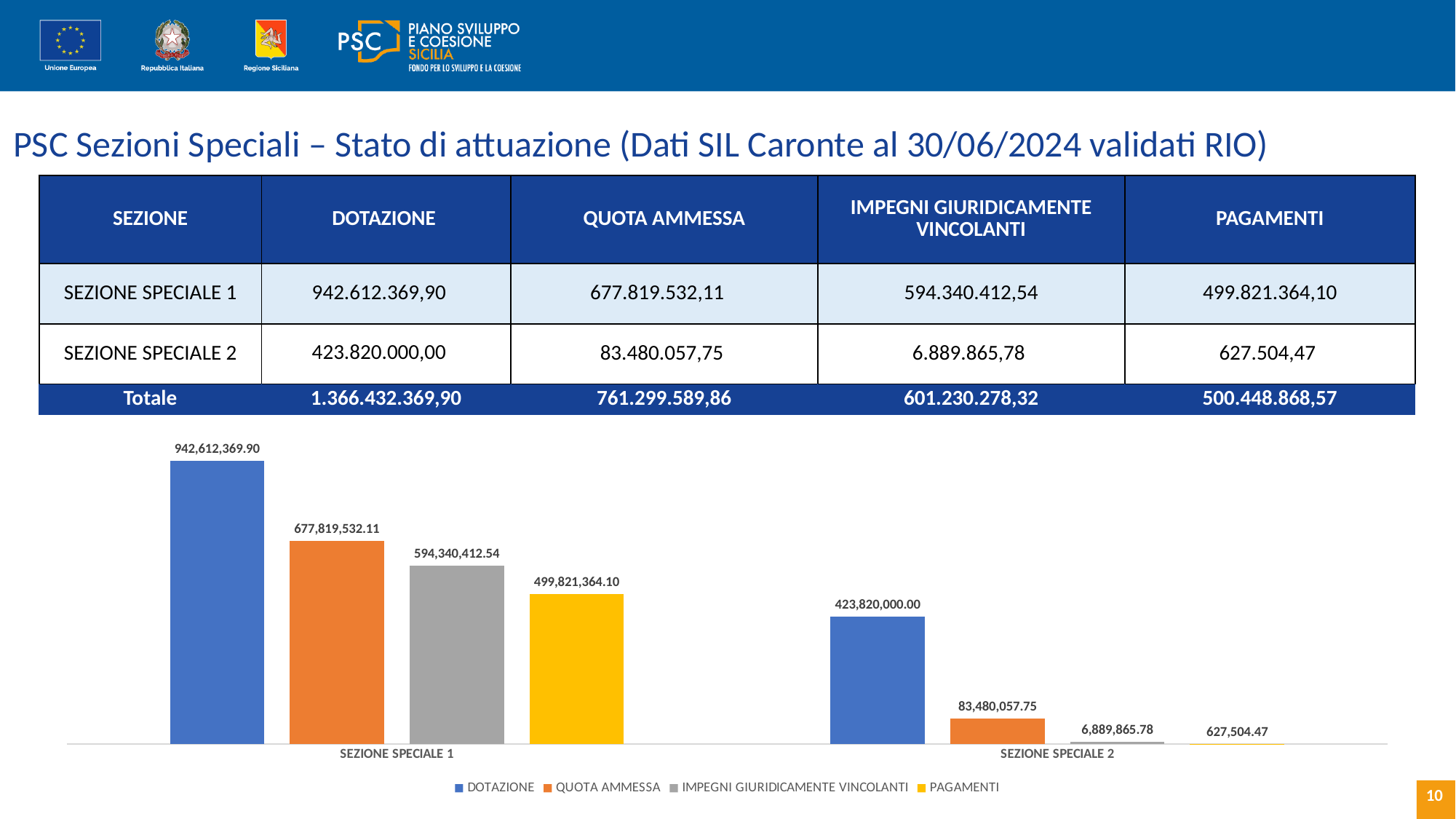
How many categories are shown on the x axis of the chart? 2 Which bar in the chart has the highest value? DOTAZIONE for SEZIONE SPECIALE 1 What is the difference between the DOTAZIONE values for SEZIONE SPECIALE 1 and SEZIONE SPECIALE 2 in the chart? 518,792,369.90 Which bar in the chart has the lowest value? PAGAMENTI for SEZIONE SPECIALE 2 What is the PAGAMENTI value for SEZIONE SPECIALE 2 in the chart? 627,504.47 How many series does the chart legend list? 4 What is the QUOTA AMMESSA value for SEZIONE SPECIALE 1 in the chart? 677,819,532.11 Which is larger in the chart: QUOTA AMMESSA for SEZIONE SPECIALE 1 or DOTAZIONE for SEZIONE SPECIALE 2? QUOTA AMMESSA for SEZIONE SPECIALE 1 Which colour represents the PAGAMENTI series in the chart? yellow What is the DOTAZIONE value for SEZIONE SPECIALE 1 in the chart? 942,612,369.90 What kind of chart is shown on the slide? bar chart What is the IMPEGNI GIURIDICAMENTE VINCOLANTI value for SEZIONE SPECIALE 2 in the chart? 6,889,865.78